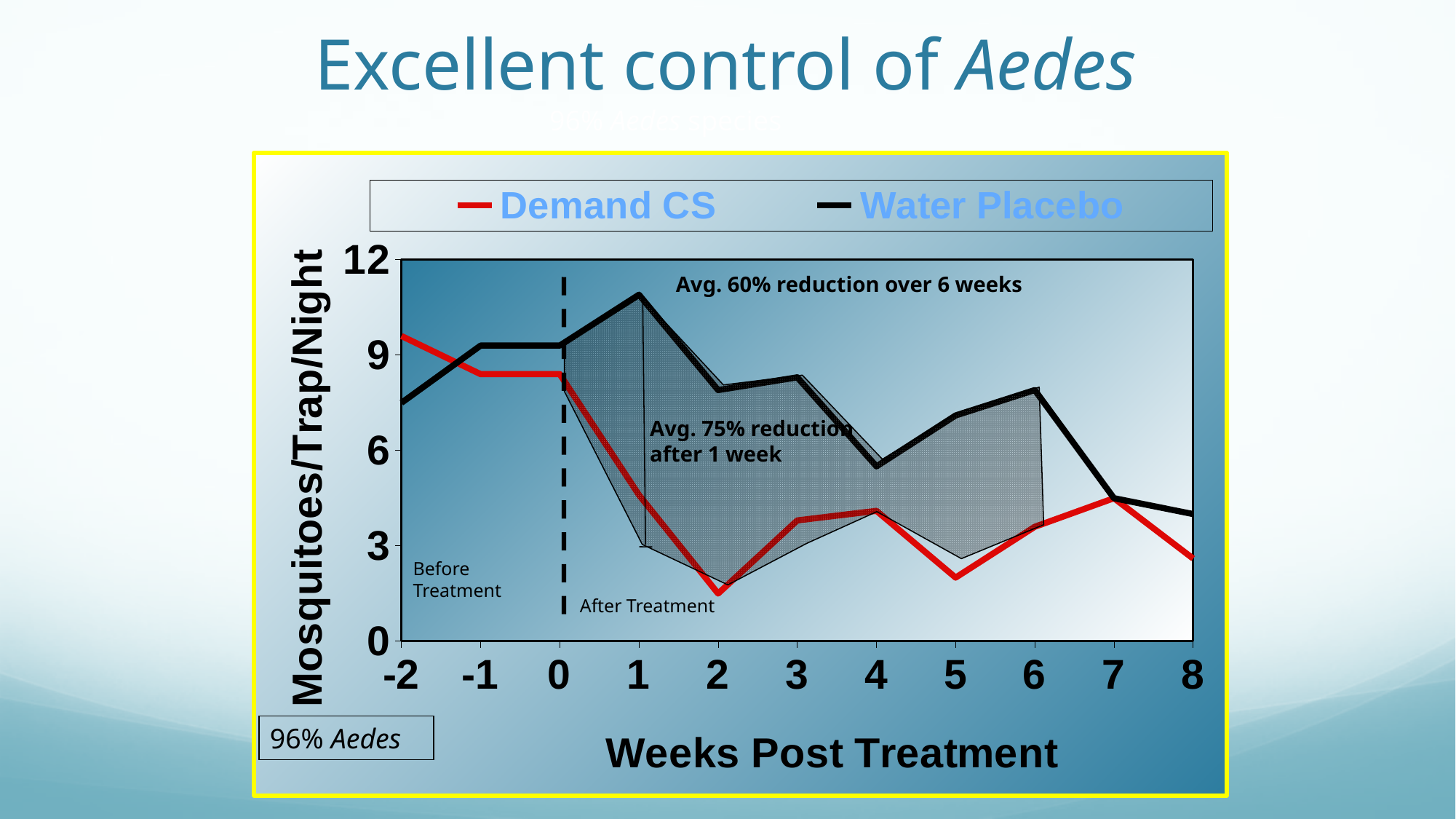
At week 5, which series has the higher value, Demand CS or Water Placebo? Water Placebo What kind of chart is shown on the slide? Line chart What is the title of the x axis? Weeks Post Treatment How many series does the legend list? 2 At week -2, which series has the higher value, Demand CS or Water Placebo? Demand CS Is the value for Demand CS at week 0 greater or less than 6? greater At which week does the Water Placebo series reach its highest value? Week 1 Is the value for Demand CS at week 2 greater or less than 3? less At which week does the Demand CS series reach its lowest value? Week 2 Does the Demand CS series rise or fall from week 0 to week 2? Fall How many week points are shown along the x axis? 11 Is the value for Water Placebo at week 1 greater or less than 9? greater